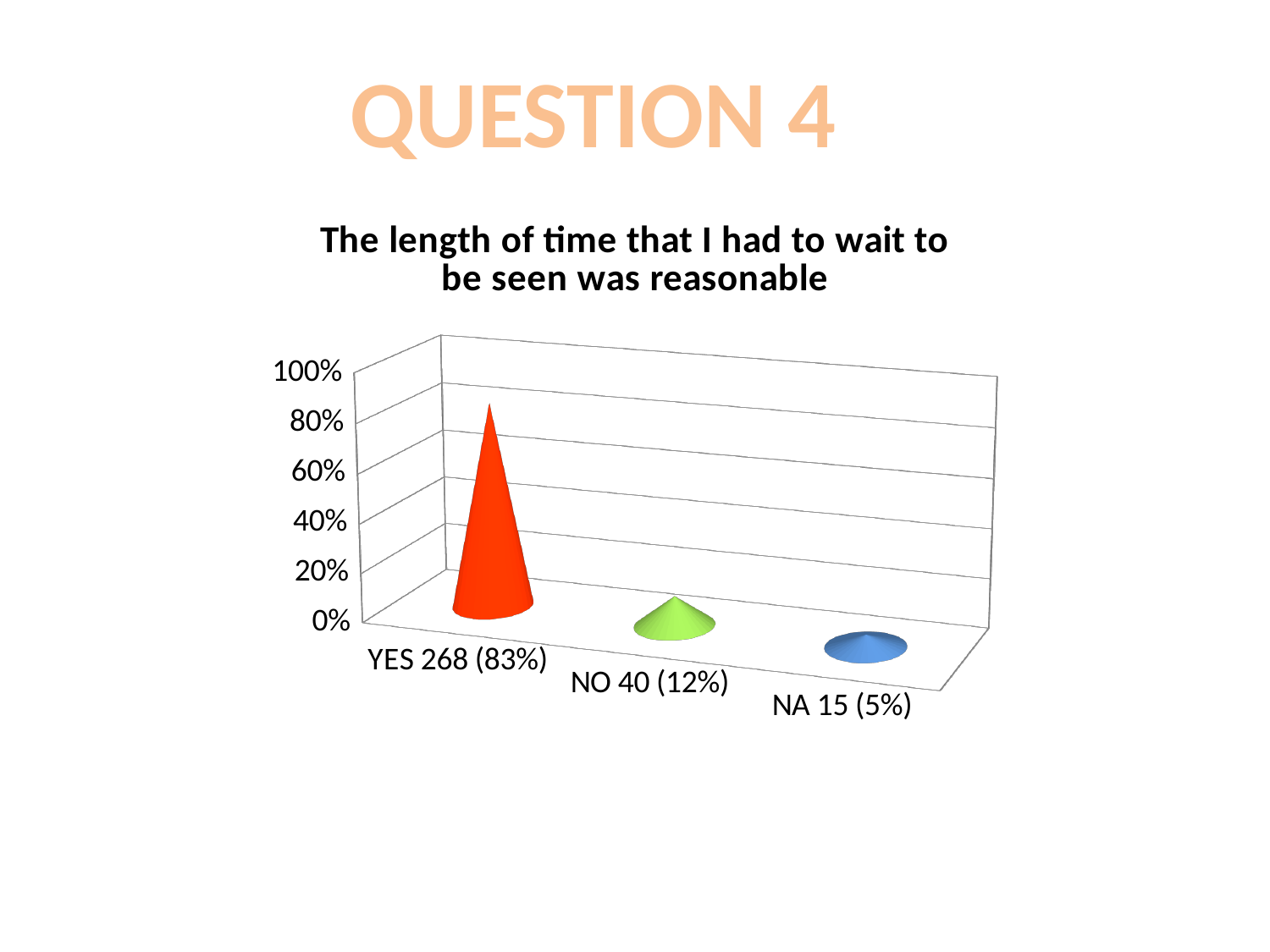
How many respondents answered NO? 40 What percentage of respondents answered YES? 83% How many categories are shown on the chart? 3 Is the value for YES greater or less than 60%? greater What kind of chart is shown on the slide? bar chart Which is larger, the value for NO or the value for NA? NO What percentage of respondents answered NA? 5% What is the difference in percentage points between YES and NO? 71 What is the title of the chart? The length of time that I had to wait to be seen was reasonable What colour is the bar for YES? red Which category has the lowest value? NA Which category has the highest value? YES